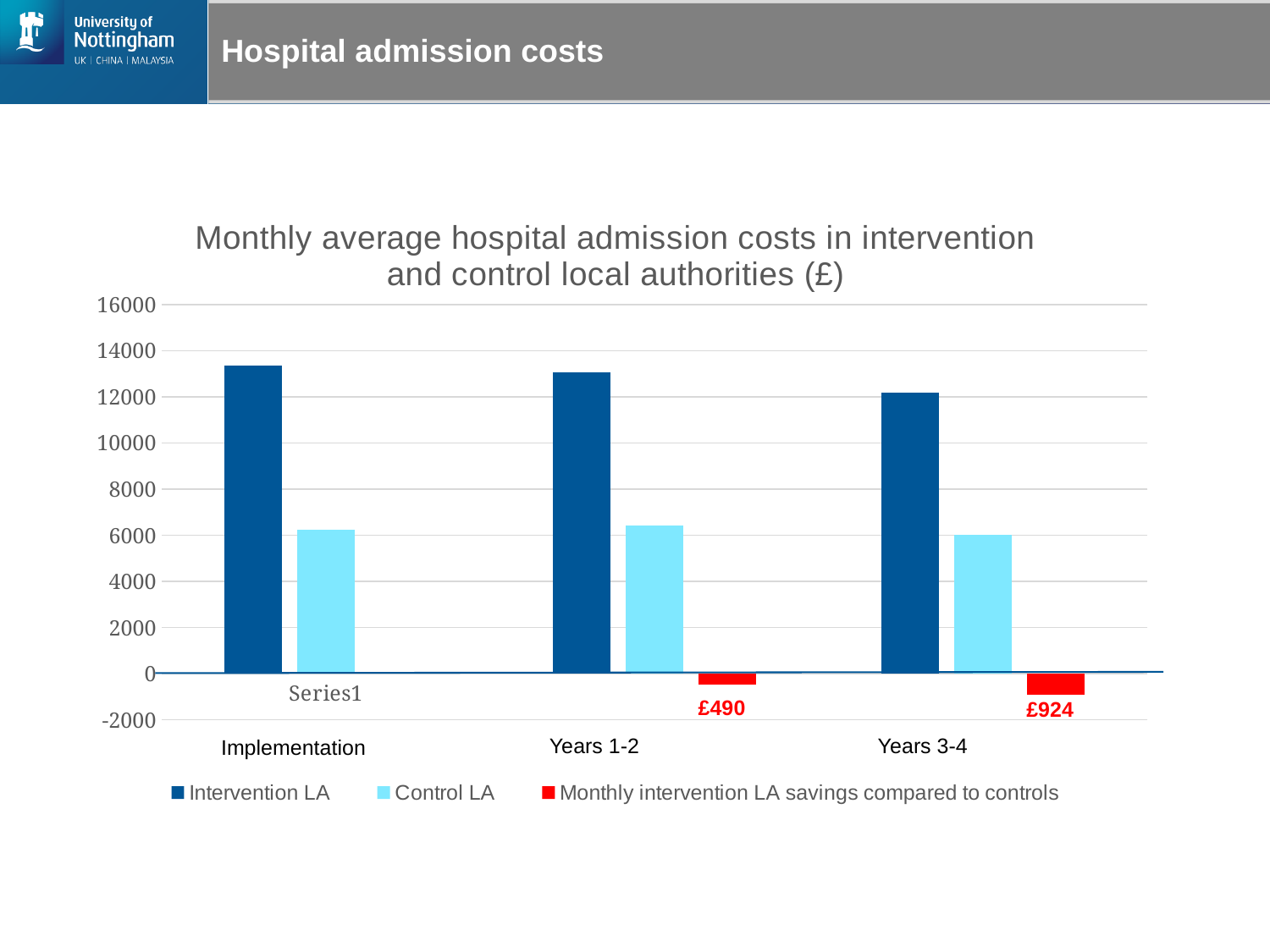
Is the Control LA value for Years 1-2 greater or less than 8000? less What is the title of the chart? Monthly average hospital admission costs in intervention and control local authorities (£) What is the labelled monthly intervention LA saving compared to controls for Years 3-4? £924 Which period has the larger labelled monthly saving, Years 1-2 or Years 3-4? Years 3-4 What kind of chart is shown on the slide? bar chart How many categories are shown along the x axis? 3 Do the Intervention LA values rise or fall from Implementation to Years 3-4? fall What is the difference between the labelled savings for Years 3-4 and Years 1-2? £434 How many series does the legend list? 3 In which period is the Intervention LA value lowest? Years 3-4 What is the labelled monthly intervention LA saving compared to controls for Years 1-2? £490 Is the Intervention LA value for Implementation greater or less than 12000? greater